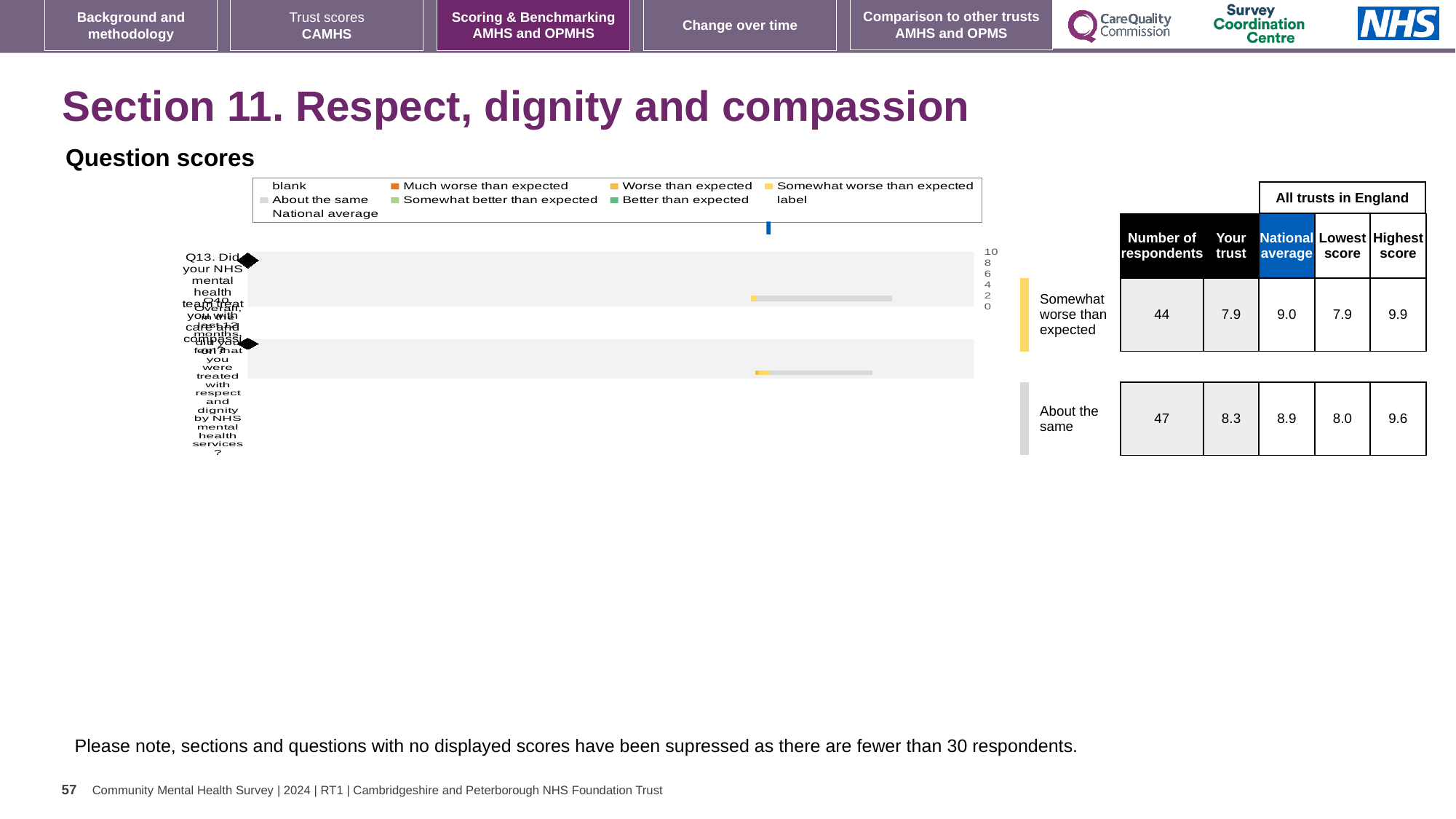
In the table beside the 'Question scores' chart, how many respondents are listed for the row rated 'Somewhat worse than expected'? 44 What kind of chart is shown under the heading 'Question scores'? bar chart What is the maximum value shown on the score axis of the 'Question scores' chart? 10 In the table beside the 'Question scores' chart, what is the 'Your trust' score for the row rated 'Somewhat worse than expected'? 7.9 In the table beside the 'Question scores' chart, what is the lowest score for the row rated 'Somewhat worse than expected'? 7.9 For the row rated 'Somewhat worse than expected', how much higher is the national average than the 'Your trust' score? 1.1 For the row rated 'About the same', what is the difference between the highest score and the lowest score? 1.6 In the table beside the 'Question scores' chart, what is the highest score for the row rated 'About the same'? 9.6 How many question bars are plotted in the 'Question scores' chart? 2 What is the heading above the chart on this slide? Question scores In the table beside the 'Question scores' chart, what is the national average for the row rated 'About the same'? 8.9 Which row has the higher 'Your trust' score: 'Somewhat worse than expected' or 'About the same'? About the same